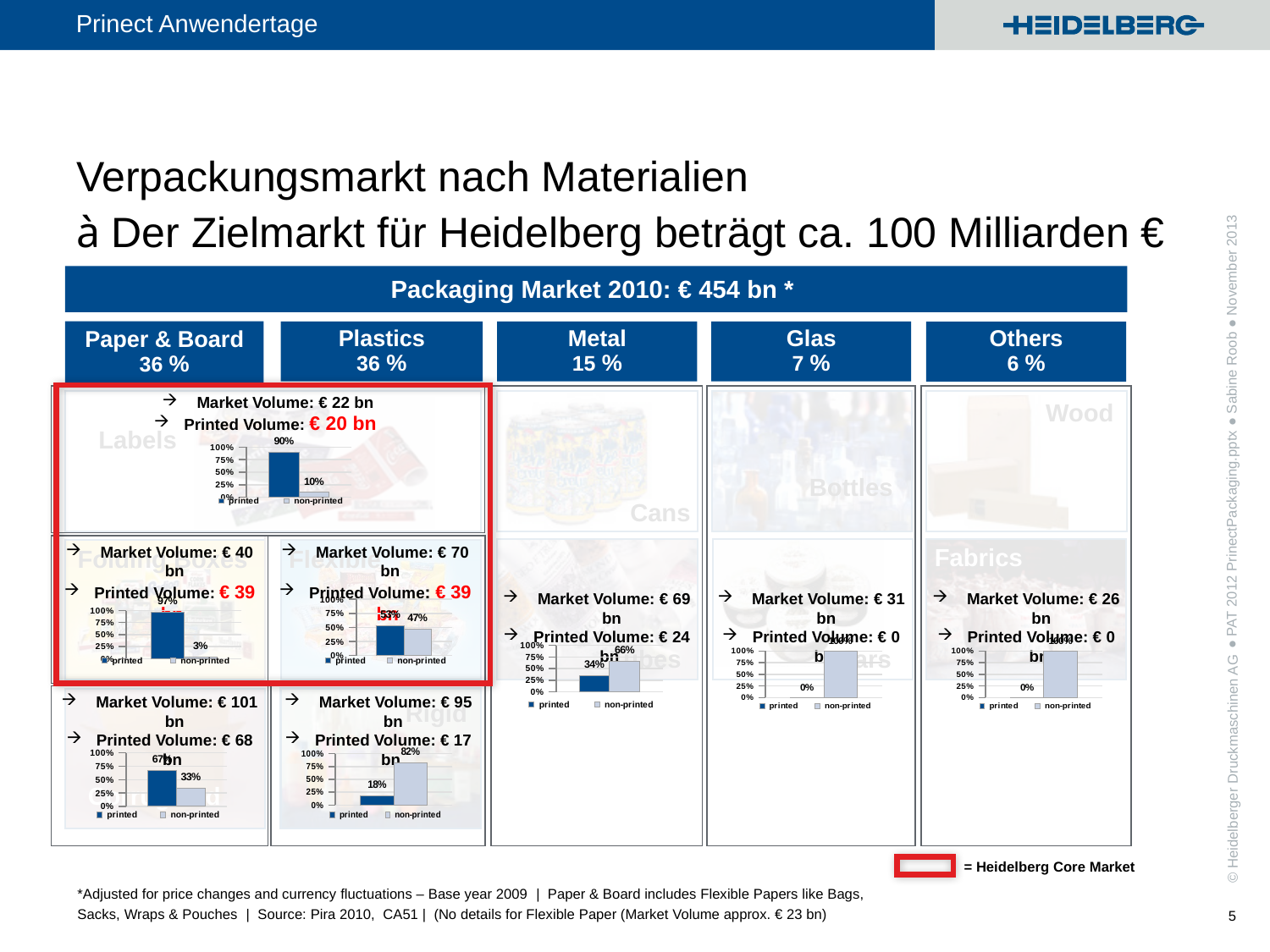
In the Corrugated chart (bottom of the Paper & Board column), what is the value for printed? 67% In the Metal (Cans) chart, what is the difference between non-printed and printed? 32% In the Metal (Cans) chart, what is the value for printed? 34% In the Folding Boxes chart (middle of the Paper & Board column), what is the value for non-printed? 3% In the Glas (Bottles) chart, what is the value for printed? 0% In the Rigid chart (bottom of the Plastics column), which is larger, printed or non-printed? non-printed In the Labels chart (top of the Paper & Board column), what is the value for printed? 90% How many series does the legend of the Metal (Cans) chart list? 2 What type of chart is used in the Labels chart (top of the Paper & Board column)? bar chart In the Rigid chart (bottom of the Plastics column), what is the value for non-printed? 82% In the Labels chart (top of the Paper & Board column), what is the value for non-printed? 10% In the Corrugated chart (bottom of the Paper & Board column), which category is highest? printed